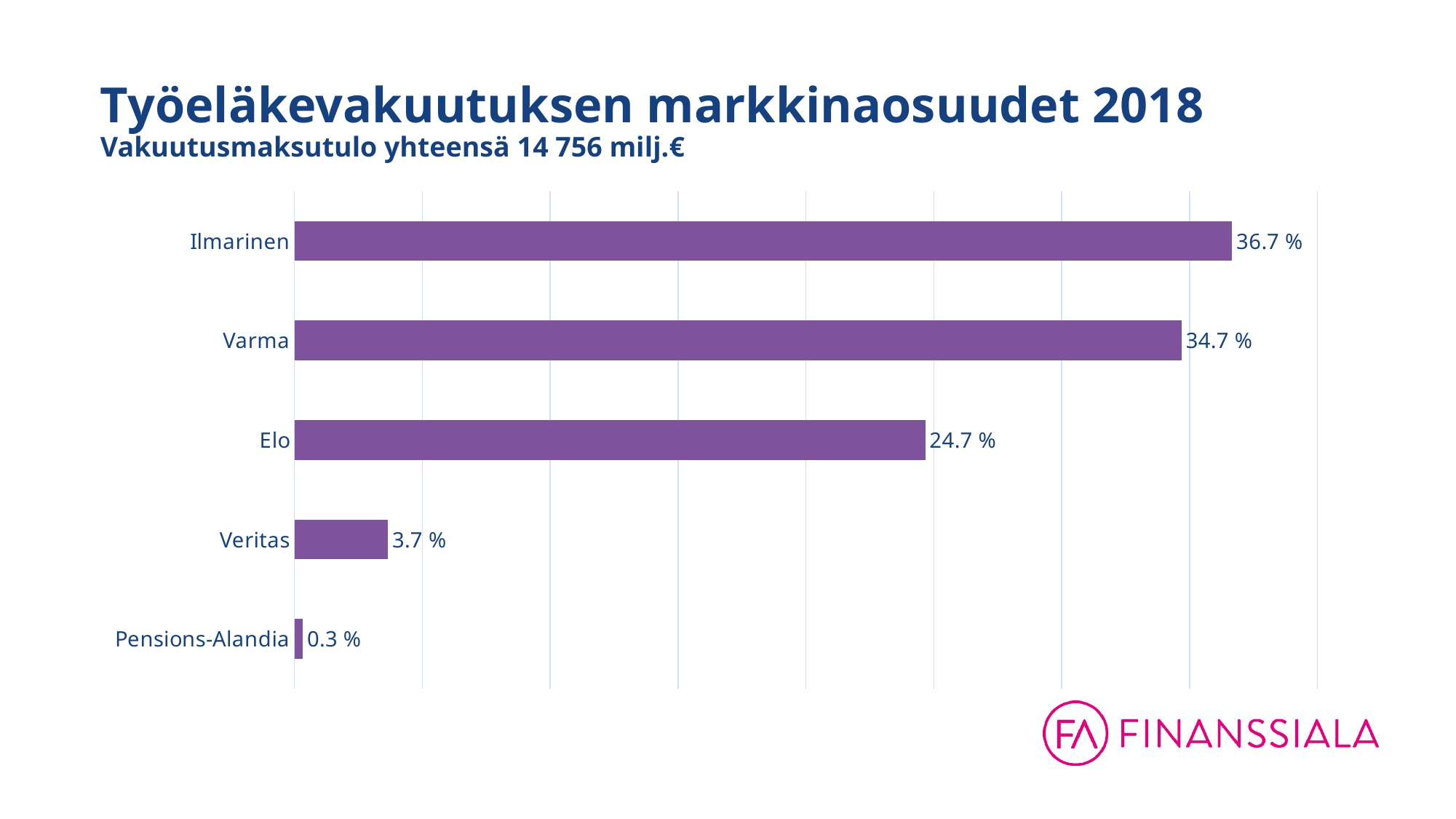
What kind of chart is shown on the slide? Bar chart What is the title of the chart? Työeläkevakuutuksen markkinaosuudet 2018 Which company has the lowest market share? Pensions-Alandia What is the market share shown for Ilmarinen? 36.7 % Which has a larger market share, Elo or Veritas? Elo Which company has the highest market share? Ilmarinen What is the market share shown for Elo? 24.7 % What is the market share shown for Pensions-Alandia? 0.3 % What is the difference in market share between Varma and Elo? 10.0 % How many companies are shown in the chart? 5 What is the market share shown for Veritas? 3.7 % What is the difference in market share between Ilmarinen and Varma? 2.0 %